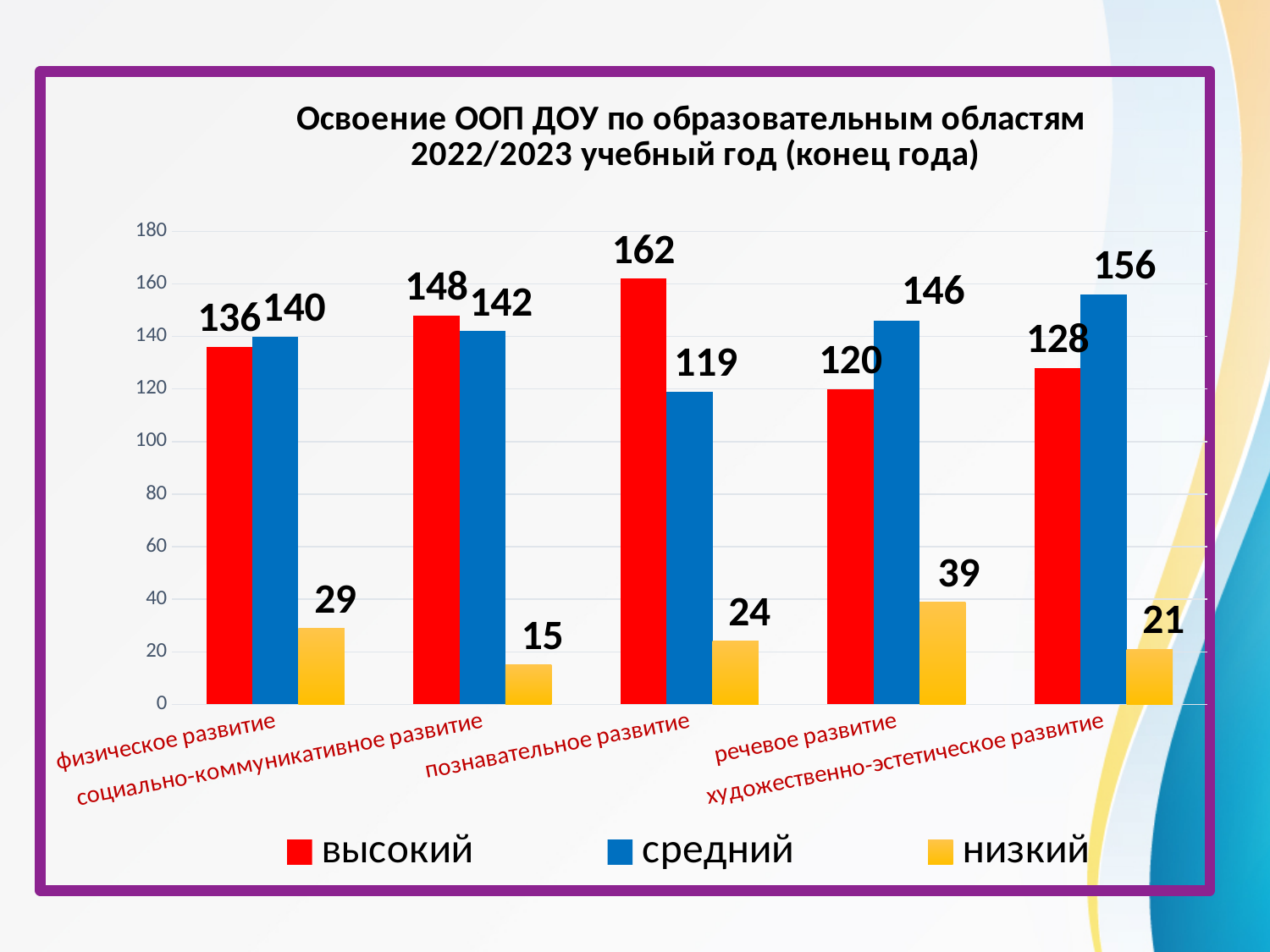
Which category has the lowest value in the 'низкий' series? социально-коммуникативное развитие What is the total of the three series for 'физическое развитие'? 305 What kind of chart is shown on the slide? bar chart What is the value of the 'средний' series for 'художественно-эстетическое развитие'? 156 What is the difference between the 'высокий' and 'средний' values for 'познавательное развитие'? 43 What is the value of the 'высокий' series for 'познавательное развитие'? 162 Which colour represents the 'низкий' series in the legend? yellow For 'речевое развитие', which is larger: the 'высокий' value or the 'средний' value? средний How many series does the legend list? 3 How many categories are shown on the x axis? 5 What is the value of the 'низкий' series for 'речевое развитие'? 39 Which category has the highest value in the 'высокий' series? познавательное развитие